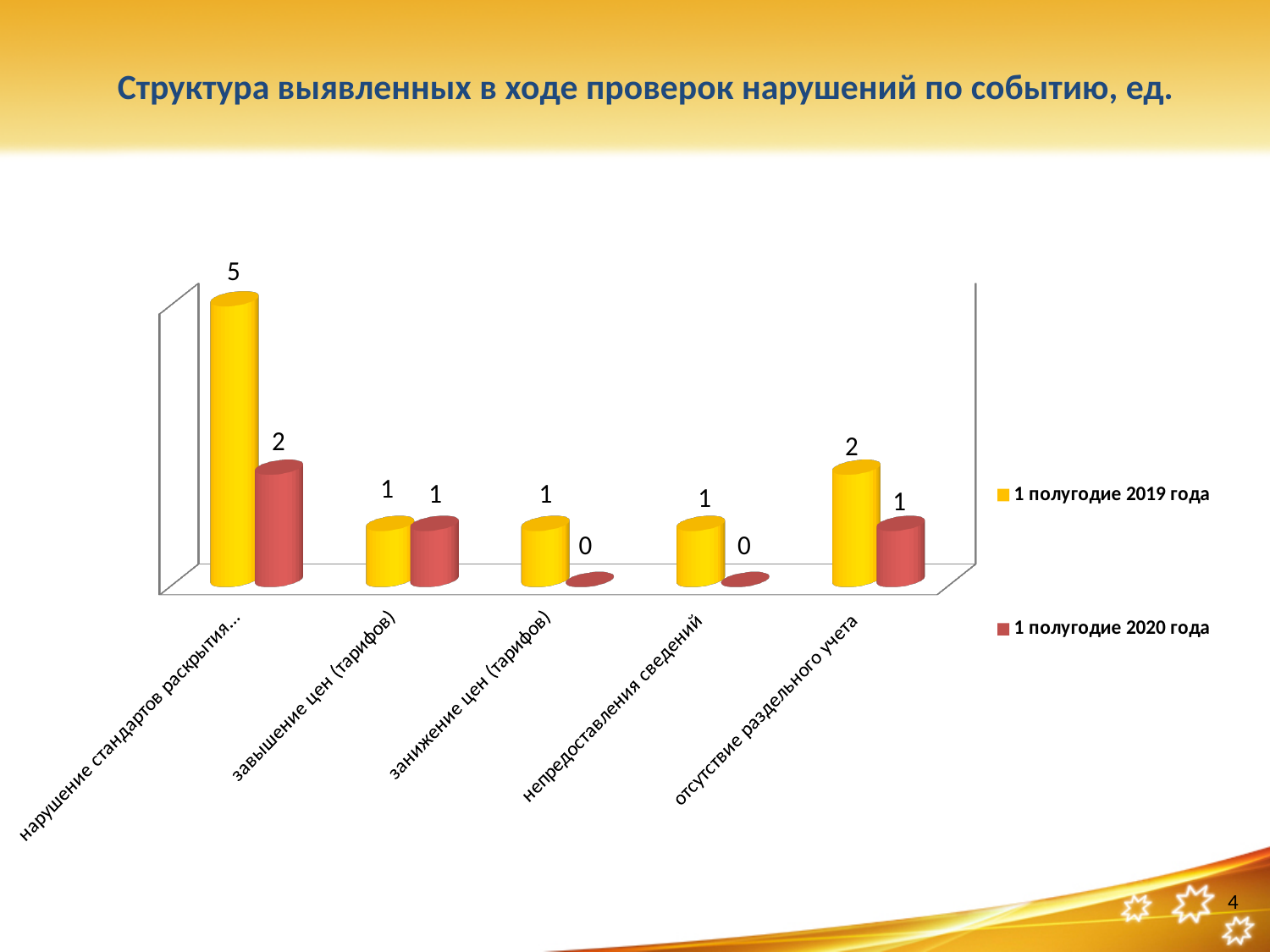
What is the difference between the 2019 and 2020 values for the first category (нарушение стандартов раскрытия...)? 3 What is the value for the first category (нарушение стандартов раскрытия...) in the series '1 полугодие 2020 года'? 2 How many categories are shown on the x axis? 5 What is the value for 'отсутствие раздельного учета' in the series '1 полугодие 2019 года'? 2 What is the value for 'завышение цен (тарифов)' in the series '1 полугодие 2020 года'? 1 How many series does the legend list? 2 For 'непредоставления сведений', which series has the larger value: '1 полугодие 2019 года' or '1 полугодие 2020 года'? 1 полугодие 2019 года Which category has the highest value in the series '1 полугодие 2019 года'? нарушение стандартов раскрытия... What is the value for the first category (нарушение стандартов раскрытия...) in the series '1 полугодие 2019 года'? 5 What type of chart is shown on the slide? bar chart What is the value for 'занижение цен (тарифов)' in the series '1 полугодие 2020 года'? 0 What colour represents the series '1 полугодие 2020 года'? red